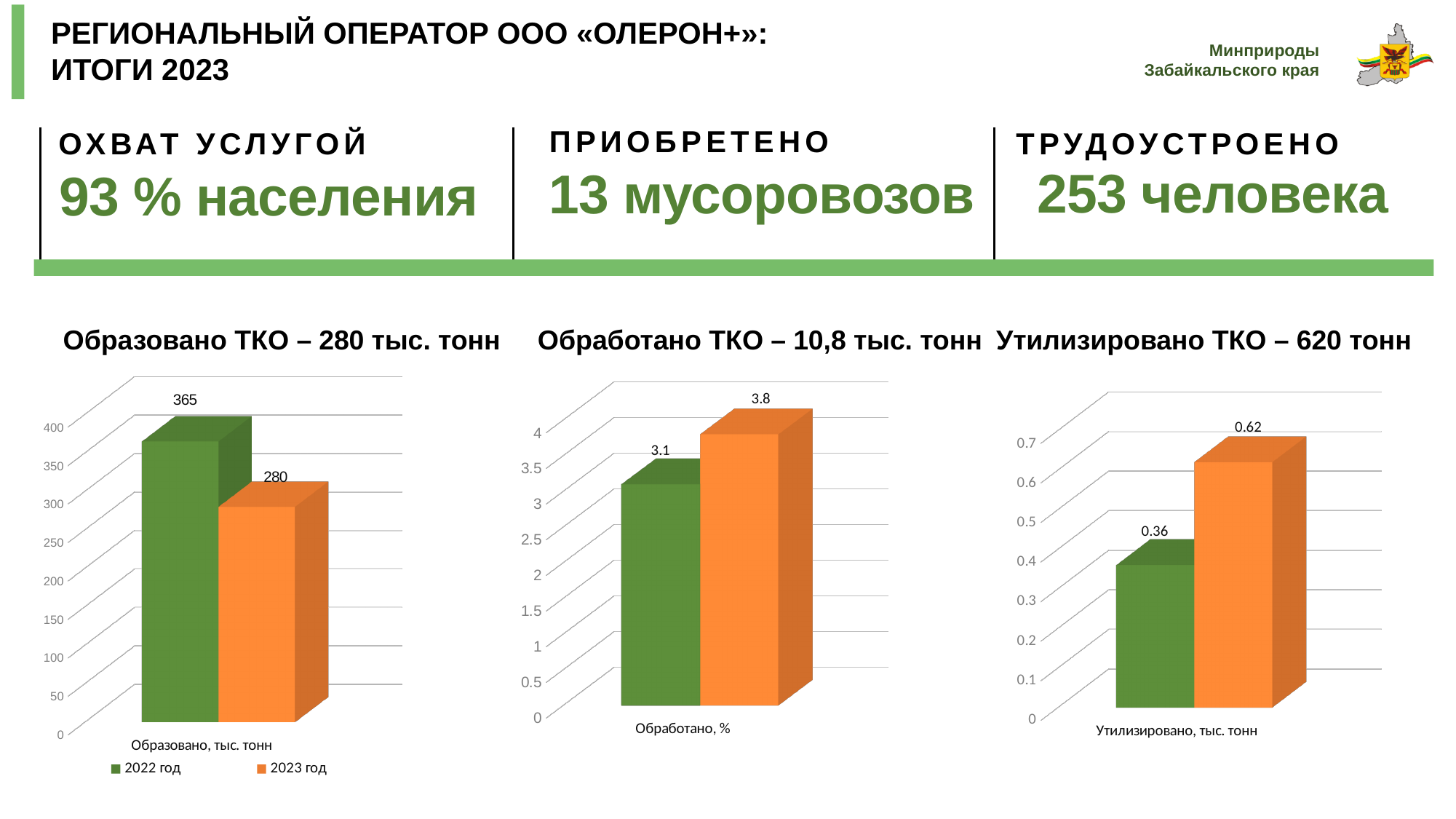
In the right chart (Утилизировано ТКО), which bar is higher, the green (2022) or the orange (2023)? orange (2023 год) In the right chart (Утилизировано ТКО), what is the value of the orange bar (2023 год)? 0.62 In the middle chart (Обработано ТКО), what is the value of the orange bar (2023 год)? 3.8 In the left chart (Образовано ТКО), what is the value for 2022 год? 365 In the left chart (Образовано ТКО), what is the value for 2023 год? 280 In the middle chart (Обработано ТКО), what is the value of the green bar (2022 год)? 3.1 In the right chart (Утилизировано ТКО), what is the value of the green bar (2022 год)? 0.36 In the middle chart (Обработано ТКО), what is the difference between the 2023 and 2022 values? 0.7 How many series does the legend of the left chart (Образовано ТКО) list? 2 In the left chart (Образовано ТКО), which year has the higher value? 2022 год In the left chart (Образовано ТКО), what is the difference between the 2022 год and 2023 год values? 85 What type of chart is used in the left chart (Образовано ТКО)? bar chart